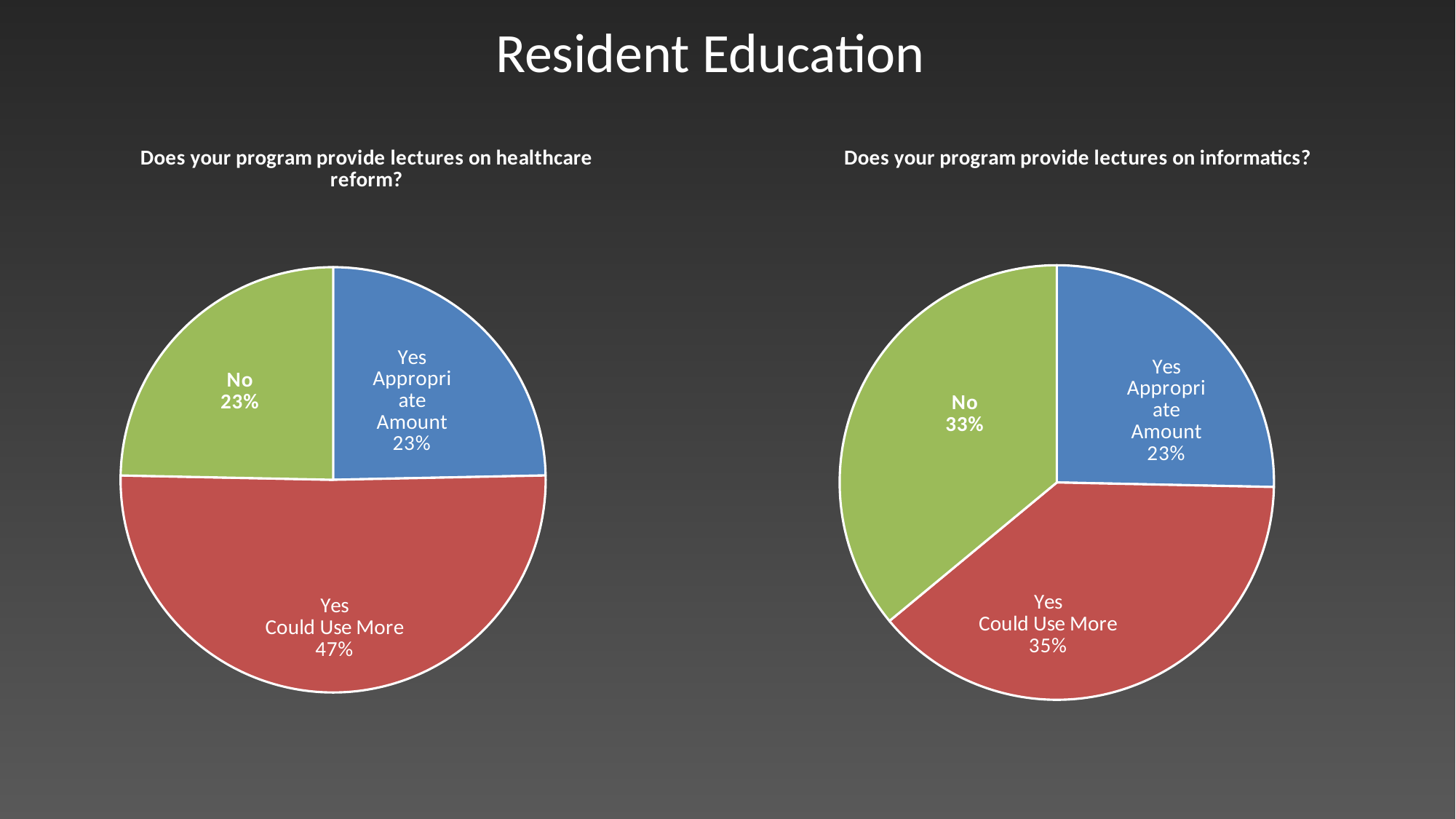
In the 'Does your program provide lectures on healthcare reform?' chart, what is the difference between the 'Yes Could Use More' share and the 'No' share? 24% In the 'Does your program provide lectures on healthcare reform?' chart, which response has the largest share? Yes Could Use More In the 'Does your program provide lectures on healthcare reform?' chart, what percentage answered 'Yes Could Use More'? 47% In the 'Does your program provide lectures on informatics?' chart, which response has the smallest share? Yes Appropriate Amount What type of chart is used for 'Does your program provide lectures on informatics?'? Pie chart In the 'Does your program provide lectures on informatics?' chart, what percentage answered 'Yes Appropriate Amount'? 23% How many slices does the 'Does your program provide lectures on healthcare reform?' chart have? 3 In the 'Does your program provide lectures on healthcare reform?' chart, what percentage answered 'No'? 23% In the 'Does your program provide lectures on informatics?' chart, what percentage answered 'No'? 33% In the 'Does your program provide lectures on informatics?' chart, what percentage answered 'Yes Could Use More'? 35% Which chart has the larger 'No' share: the healthcare reform chart or the informatics chart? The informatics chart In the 'Does your program provide lectures on informatics?' chart, what is the difference between the 'No' share and the 'Yes Appropriate Amount' share? 10%